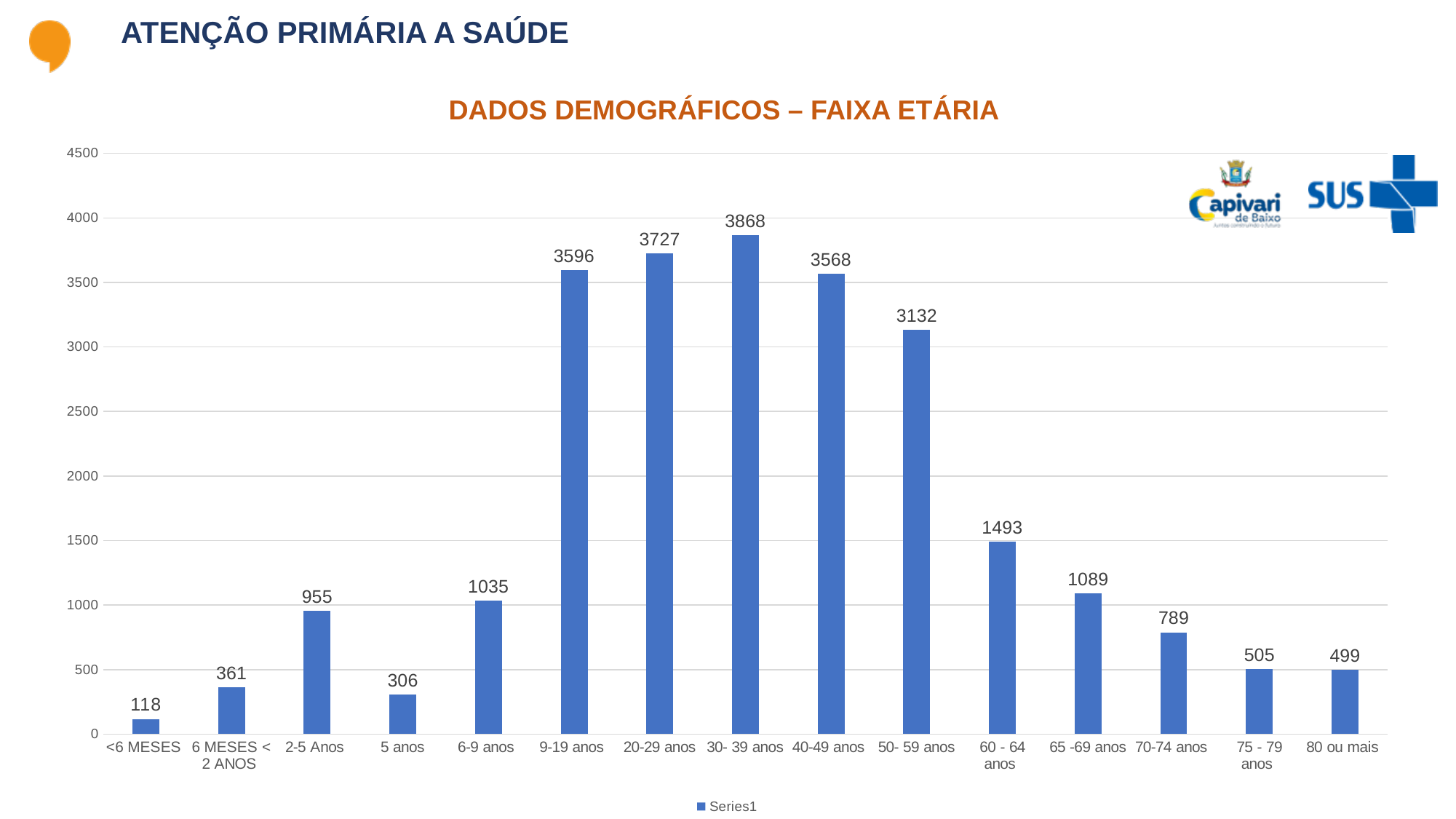
What is the value for the 60 - 64 anos age group? 1493 What is the title of the chart? DADOS DEMOGRÁFICOS – FAIXA ETÁRIA What is the difference between the values for 20-29 anos and 9-19 anos? 131 What is the value for the 30- 39 anos age group? 3868 What is the difference between the values for 2-5 Anos and 5 anos? 649 Is the value for 65 -69 anos greater or less than 1000? greater Which age group has the lowest value? <6 MESES How many age group categories are shown on the x axis? 15 Which is larger, the value for 40-49 anos or the value for 50- 59 anos? 40-49 anos What is the value for the <6 MESES category? 118 Which age group has the highest value? 30- 39 anos What kind of chart is shown on the slide? bar chart